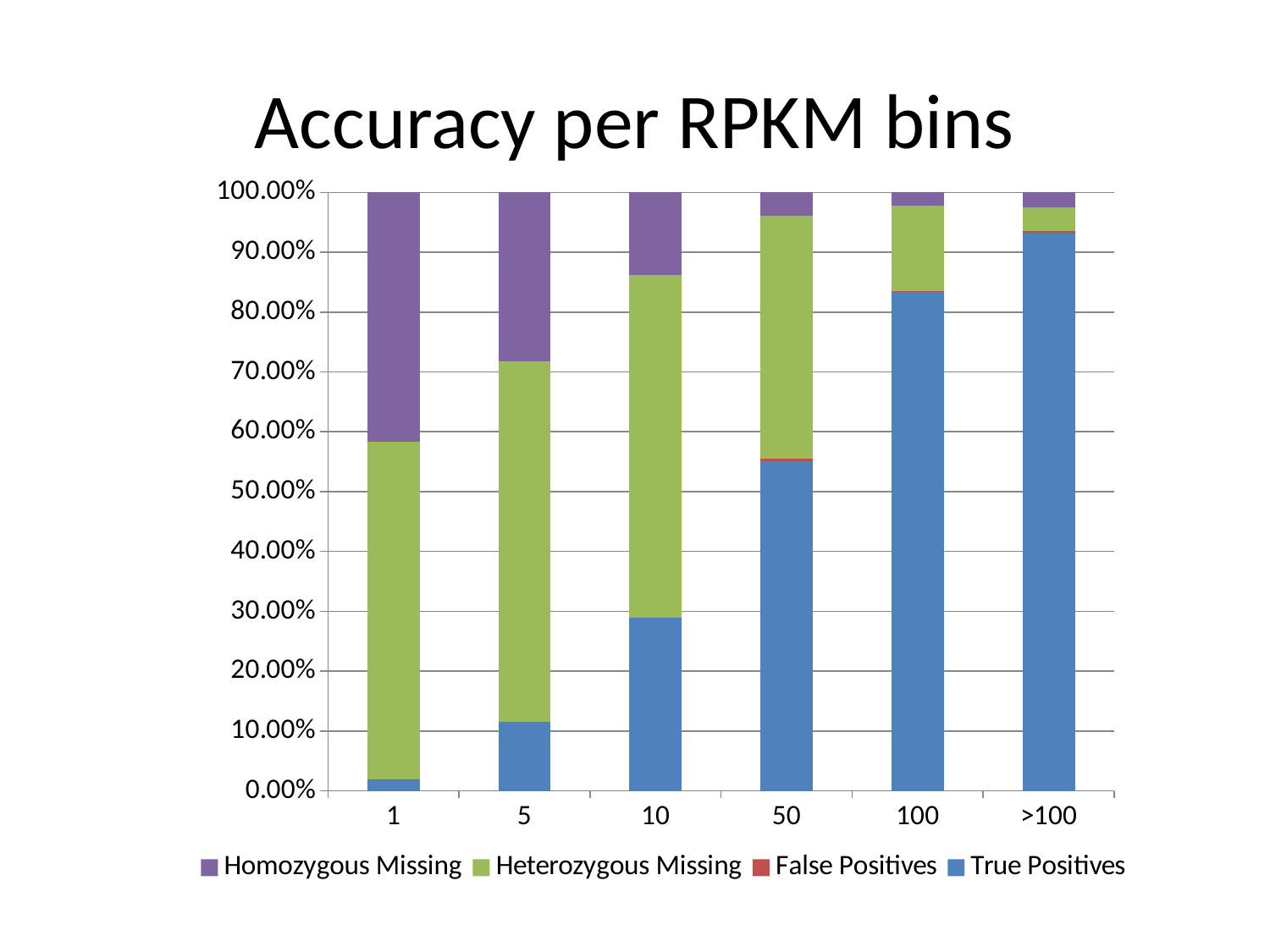
Which RPKM bin has the largest True Positives share? >100 What kind of chart is shown on the slide? Stacked bar chart Which RPKM bin has the largest Homozygous Missing share? 1 Which is larger, the True Positives share for the 50 bin or for the 10 bin? 50 What is the title of the chart? Accuracy per RPKM bins How many RPKM bin categories are shown on the x axis? 6 Is the True Positives value for the 1 bin greater or less than 10.00%? less Is the True Positives value for the >100 bin greater or less than 90.00%? greater How many series does the legend list? 4 Which RPKM bin has the smallest True Positives share? 1 Does the True Positives share rise or fall as the RPKM bins increase along the x axis? Rise Which series is shown in blue in the legend? True Positives